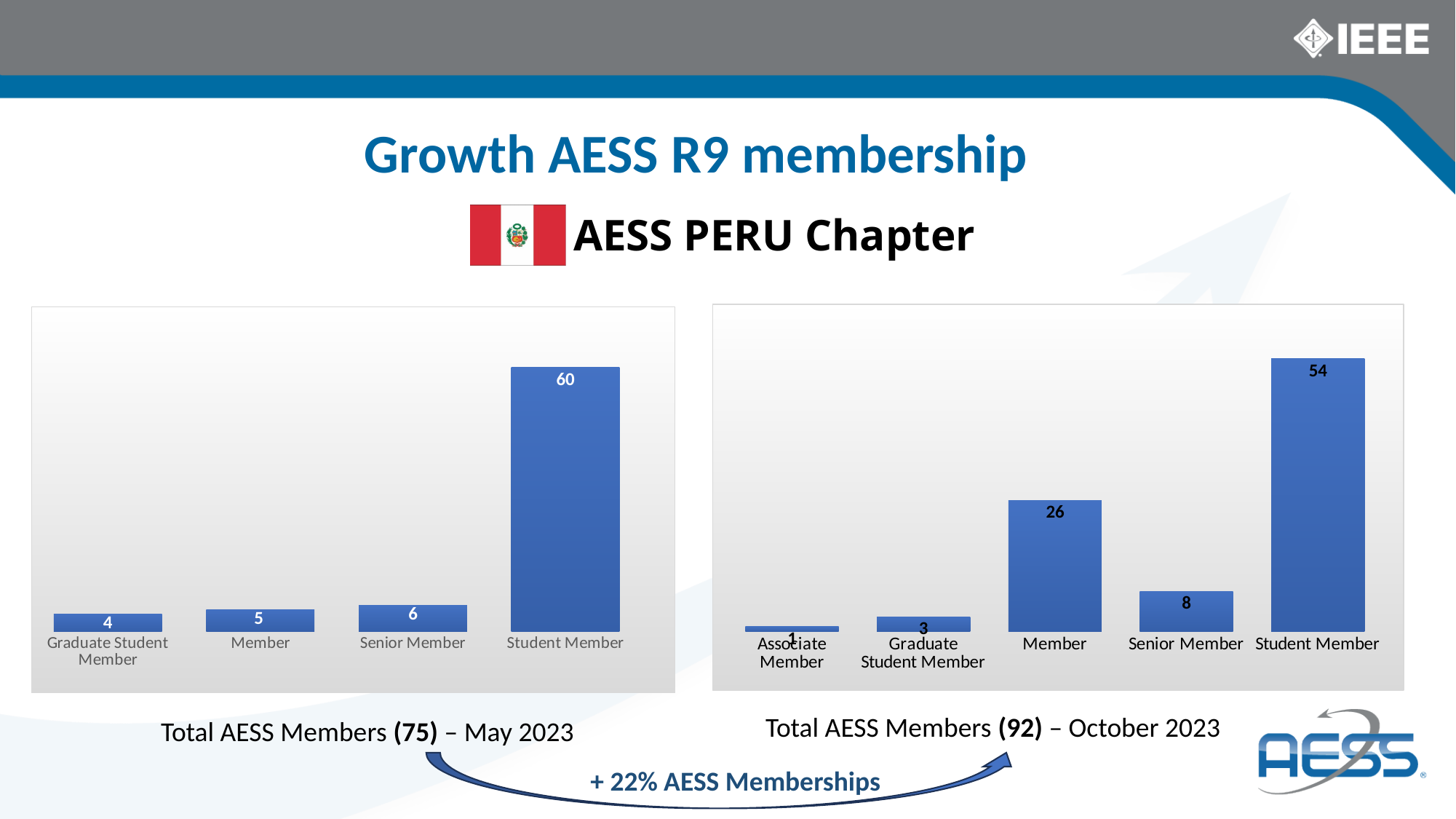
In the right chart (October 2023), which is larger, Senior Member or Graduate Student Member? Senior Member In the left chart (May 2023), what is the value for Student Member? 60 In the right chart (October 2023), what is the difference between Student Member and Member? 28 How many categories are shown in the right chart (October 2023)? 5 In the left chart (May 2023), do the values rise or fall from left to right along the x axis? Rise In the right chart (October 2023), what is the value for Member? 26 In the left chart (May 2023), what is the difference between Senior Member and Graduate Student Member? 2 How many categories are shown in the left chart (May 2023)? 4 In the right chart (October 2023), what is the value for Associate Member? 1 In the left chart (May 2023), which category has the lowest value? Graduate Student Member In the right chart (October 2023), which category has the highest value? Student Member What kind of chart is the right chart (October 2023)? Bar chart